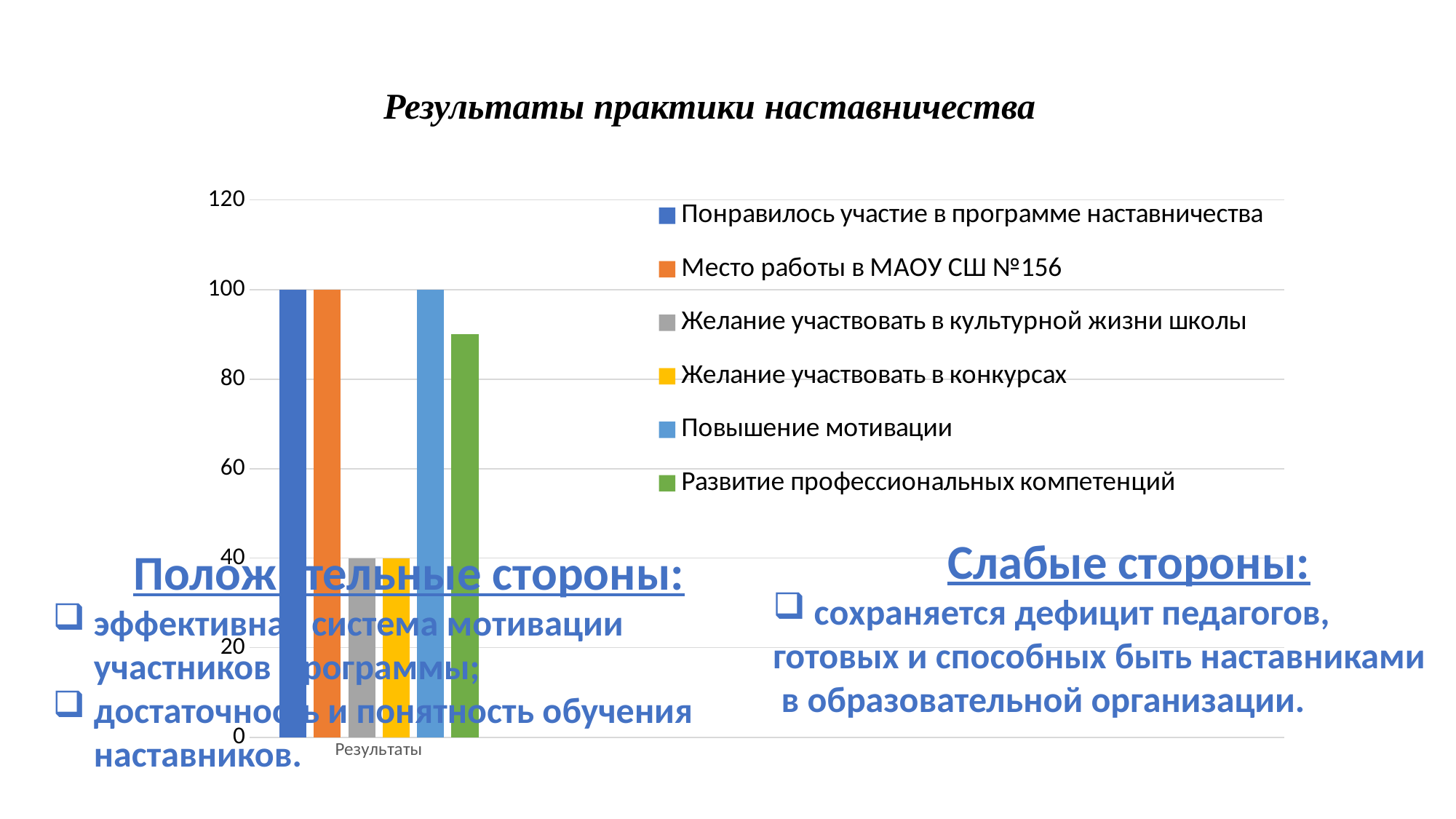
What is the value for "Желание участвовать в конкурсах"? 40 What is the value for "Желание участвовать в культурной жизни школы"? 40 What is the title of the chart on the slide? Результаты практики наставничества What kind of chart is shown on the slide? bar chart Which is larger: "Место работы в МАОУ СШ №156" or "Желание участвовать в конкурсах"? Место работы в МАОУ СШ №156 What is the value for "Повышение мотивации"? 100 What is the difference between the values for "Понравилось участие в программе наставничества" and "Желание участвовать в культурной жизни школы"? 60 Is the value for "Развитие профессиональных компетенций" greater or less than 80? greater How many categories are shown on the x axis of the chart? 1 Which is larger: "Развитие профессиональных компетенций" or "Желание участвовать в культурной жизни школы"? Развитие профессиональных компетенций How many series does the chart legend list? 6 What is the value for "Место работы в МАОУ СШ №156"? 100